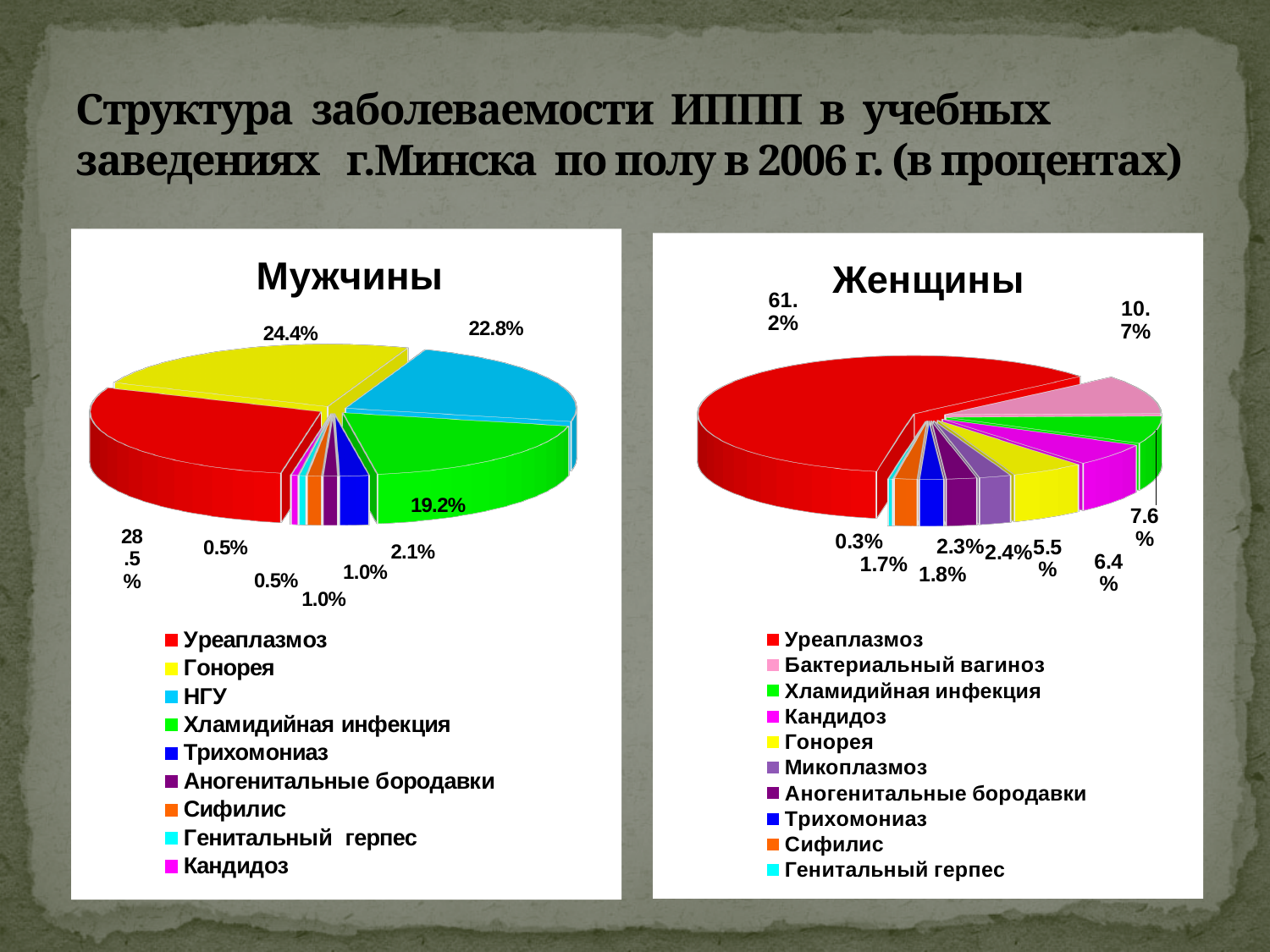
In the "Мужчины" chart, what is the share for Хламидийная инфекция? 19.2% In the "Мужчины" chart, what is the share for Гонорея? 24.4% In the "Мужчины" chart, what is the difference between the shares for Уреаплазмоз and Гонорея? 4.1% In the "Женщины" chart, what is the share for Уреаплазмоз? 61.2% In the "Женщины" chart, what is the share for Бактериальный вагиноз? 10.7% Which chart has the larger share for Уреаплазмоз, "Мужчины" or "Женщины"? Женщины In the "Женщины" chart, which category has the largest share? Уреаплазмоз How many categories does the legend of the "Женщины" chart list? 10 In the "Мужчины" chart, which category has the largest share? Уреаплазмоз In the "Мужчины" chart, what is the share for НГУ? 22.8% How many categories does the legend of the "Мужчины" chart list? 9 What type of chart is used for the "Мужчины" chart? pie chart